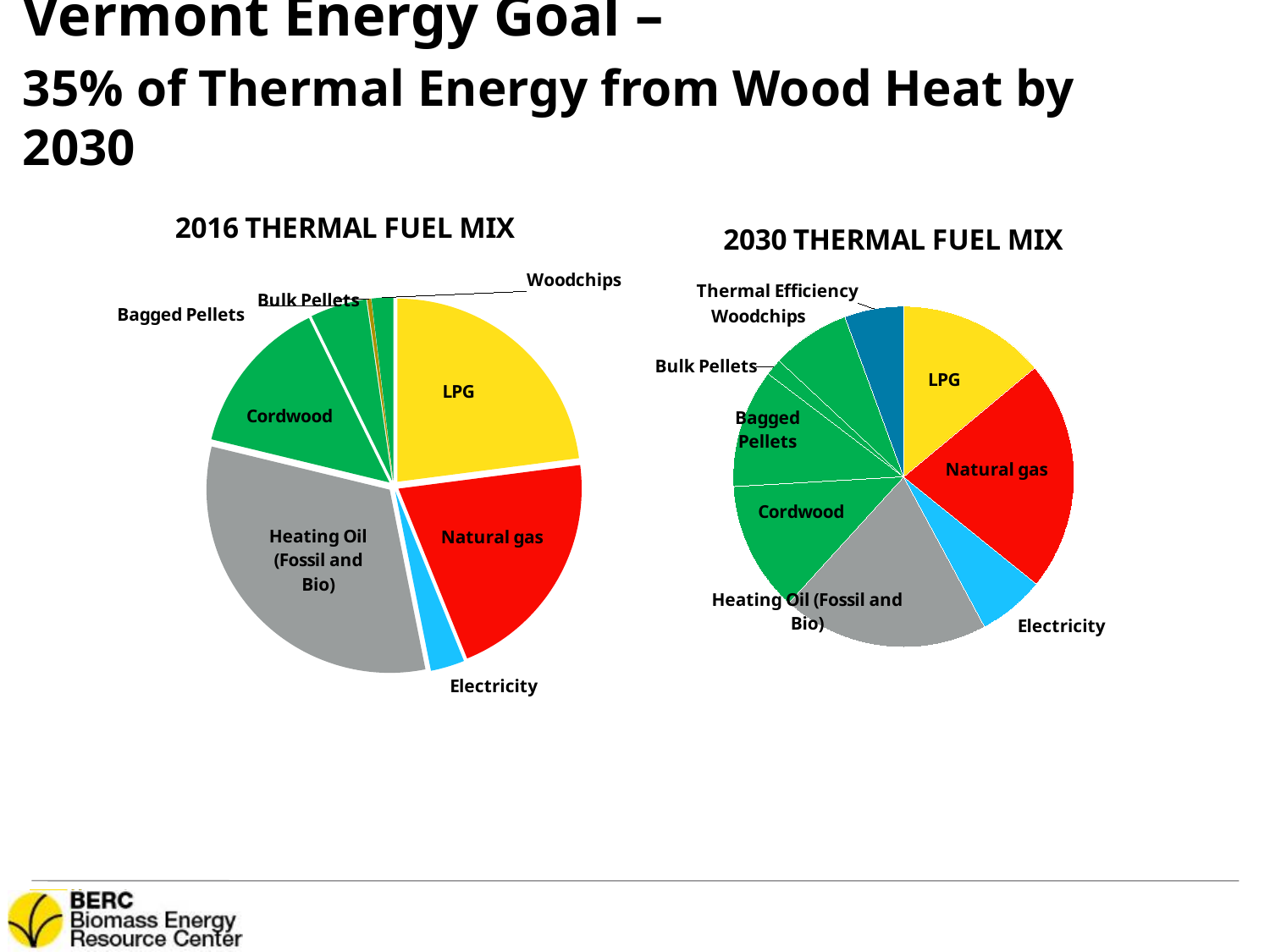
In the 2030 THERMAL FUEL MIX chart, which slice is larger, Cordwood or Thermal Efficiency? Cordwood In the 2016 THERMAL FUEL MIX chart, which labeled category has the smallest slice? Bulk Pellets In the 2030 THERMAL FUEL MIX chart, which slice is larger, Natural gas or Electricity? Natural gas What kind of chart is the 2016 THERMAL FUEL MIX chart? Pie chart How many labeled slices does the 2030 THERMAL FUEL MIX chart have? 9 What is the title of the chart on the left side of the slide? 2016 THERMAL FUEL MIX In the 2016 THERMAL FUEL MIX chart, which slice is larger, Cordwood or Electricity? Cordwood In the 2030 THERMAL FUEL MIX chart, which category has the smallest slice? Bulk Pellets In the 2030 THERMAL FUEL MIX chart, which category has the largest slice? Natural gas In the 2016 THERMAL FUEL MIX chart, which category has the largest slice? Heating Oil (Fossil and Bio) In the 2030 THERMAL FUEL MIX chart, what colour is the Natural gas slice? Red